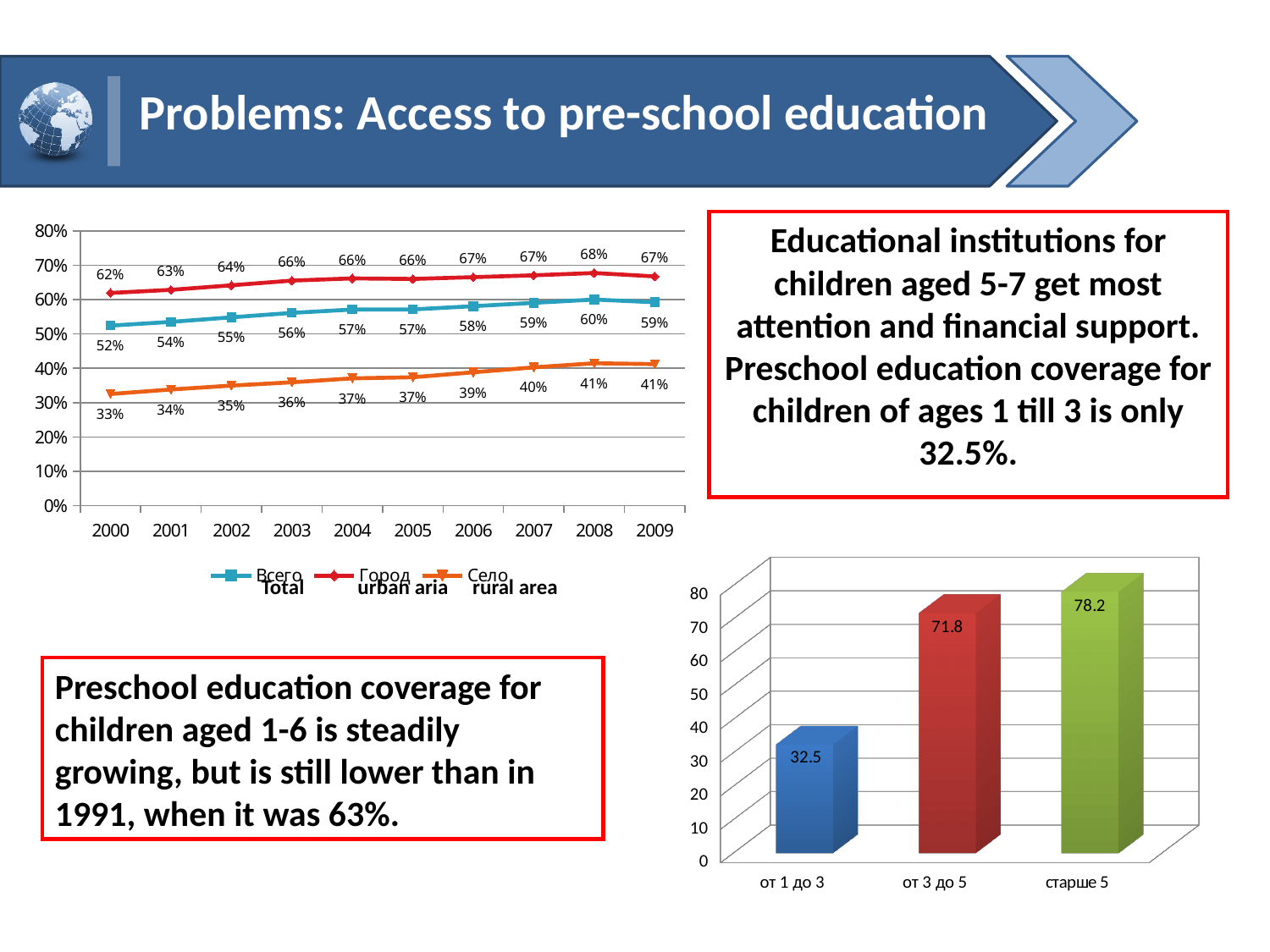
In the line chart on the left, what is the Total value for 2000? 52% In the line chart on the left, what is the rural area value for 2009? 41% In the line chart on the left, what is the difference between the urban area and rural area values in 2005? 29% In the line chart on the left, how many series does the legend list? 3 In the line chart on the left, what is the urban area value for 2008? 68% In the line chart on the left, how many years are shown on the x axis? 10 In the line chart on the left, in which year is the Total series highest? 2008 In the bar chart on the bottom right, what is the difference between 'старше 5' and 'от 1 до 3'? 45.7 In the bar chart on the bottom right, what is the value for 'от 3 до 5'? 71.8 In the bar chart on the bottom right, which category has the lowest value? от 1 до 3 In the line chart on the left, in which year is the rural area series lowest? 2000 In the line chart on the left, does the rural area series generally rise or fall from 2000 to 2009? rise